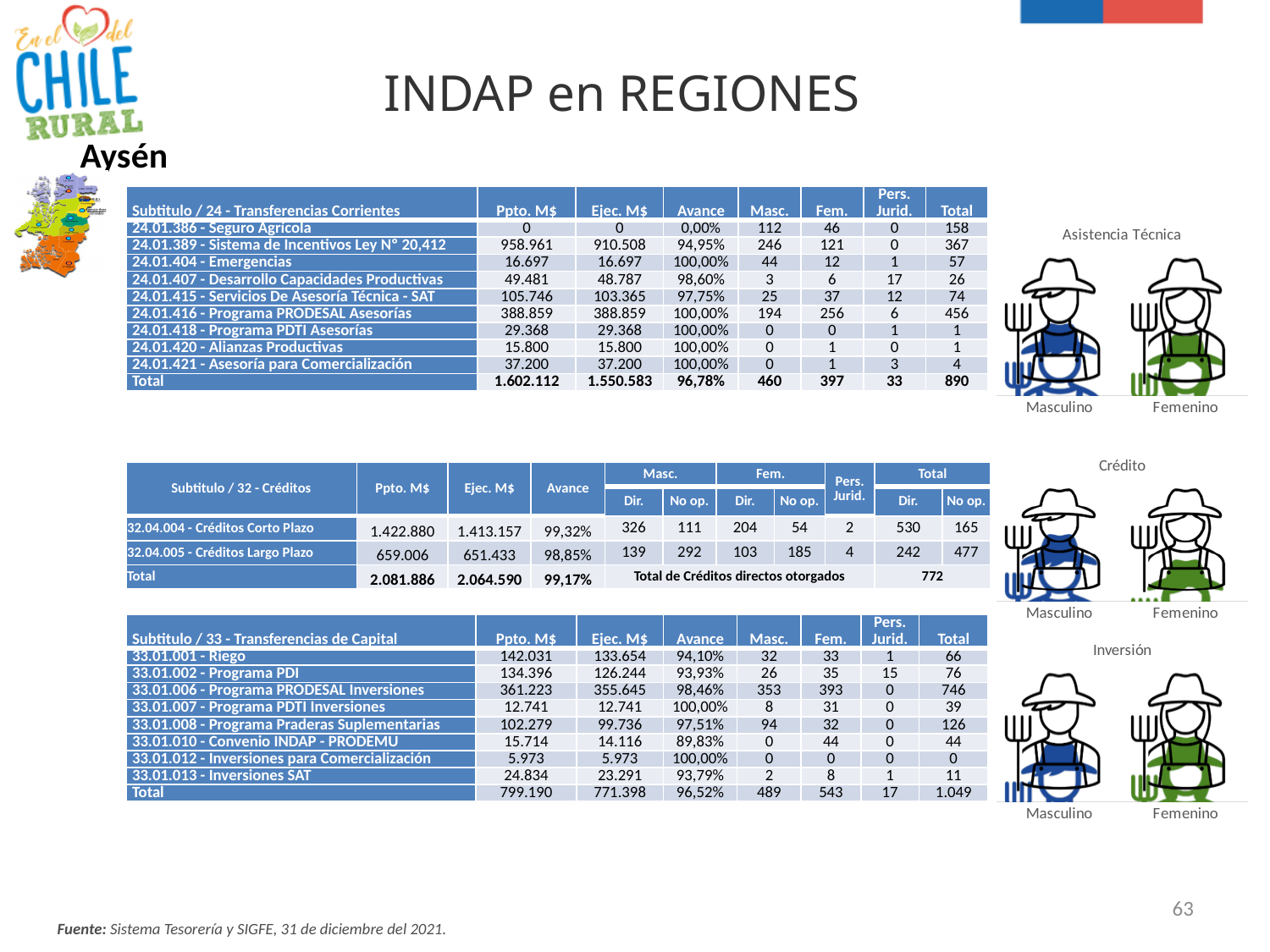
What is the title of the bottom pictogram chart on the slide? Inversión What colour is used for the Femenino icon in the Inversión chart? green In the Crédito chart, which category has the larger filled share, Masculino or Femenino? Masculino How many categories does the Asistencia Técnica chart show? 2 What are the two categories shown in the Crédito chart? Masculino and Femenino What kind of chart is used for the Asistencia Técnica chart on the right of the slide? pictogram (filled icon) chart How many pictogram charts are shown on the right side of the slide? 3 In the Asistencia Técnica chart, which category has the larger filled share, Masculino or Femenino? Masculino